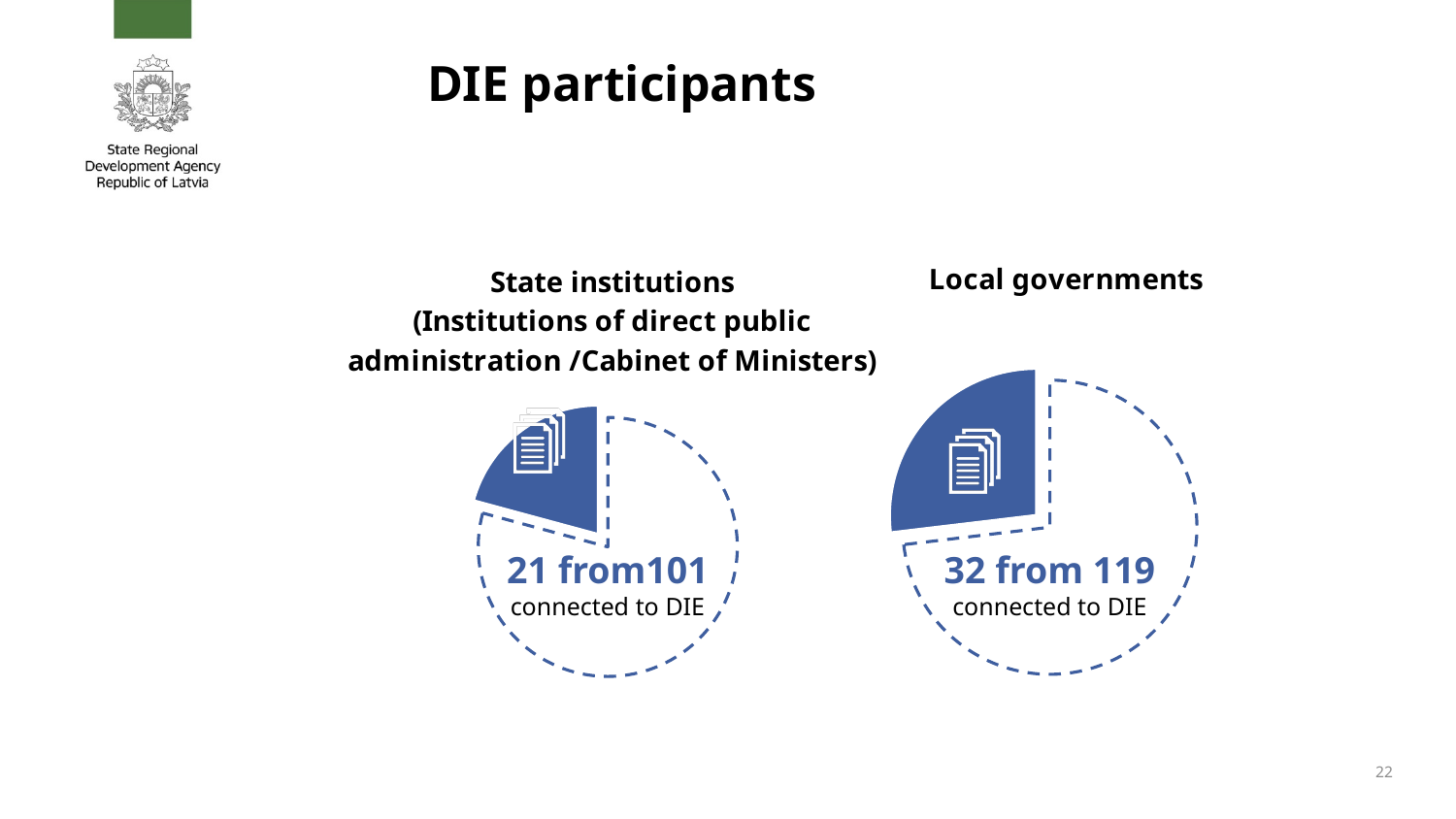
In the State institutions chart, how many institutions are not connected to DIE? 80 What colour is the filled slice representing the connected participants in both charts? Blue In the Local governments chart, how many local governments are not connected to DIE? 87 Which group has more members connected to DIE, State institutions or Local governments? Local governments In the State institutions chart, what is the total number of institutions? 101 In the State institutions chart, how many institutions are connected to DIE? 21 What kind of chart is used to show the DIE participants on this slide? Pie chart In the Local governments chart, what is the total number of local governments? 119 In the Local governments chart, how many local governments are connected to DIE? 32 What is the title of the slide containing the two charts? DIE participants How many more local governments than state institutions are connected to DIE? 11 How many charts are shown on the slide? 2